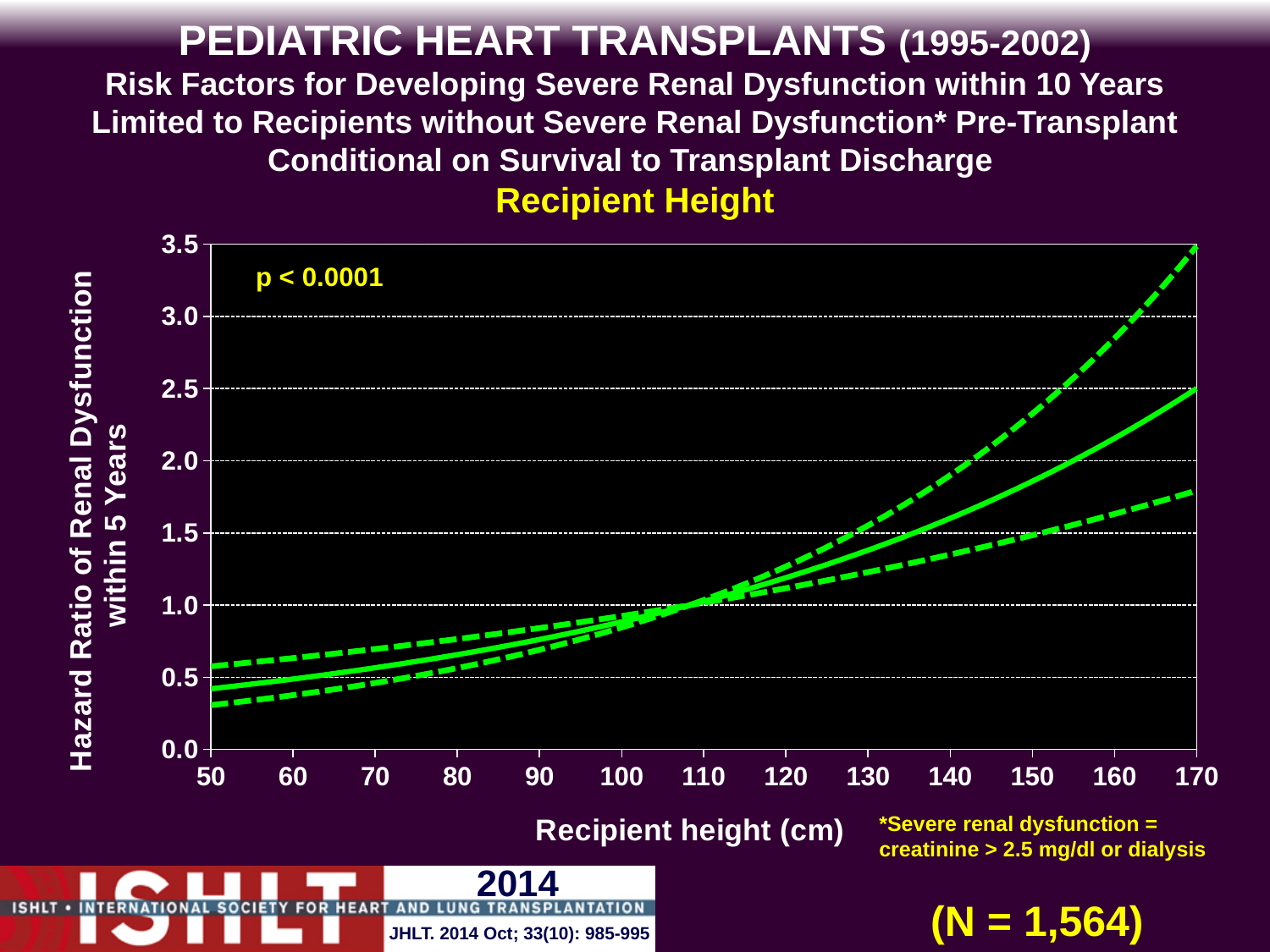
How many lines are plotted on the chart? 3 Is the hazard ratio on the solid line at a recipient height of 130 cm greater or less than 1.0? greater Is the hazard ratio on the solid line at a recipient height of 100 cm greater or less than 1.0? less Is the value of the lower dashed line at a recipient height of 50 cm greater or less than 0.5? less What is the label of the x axis of the chart? Recipient height (cm) What p-value is printed on the chart? p < 0.0001 What kind of chart is shown on the slide? line chart Does the solid hazard ratio line rise or fall as recipient height increases from 50 cm to 170 cm? rises